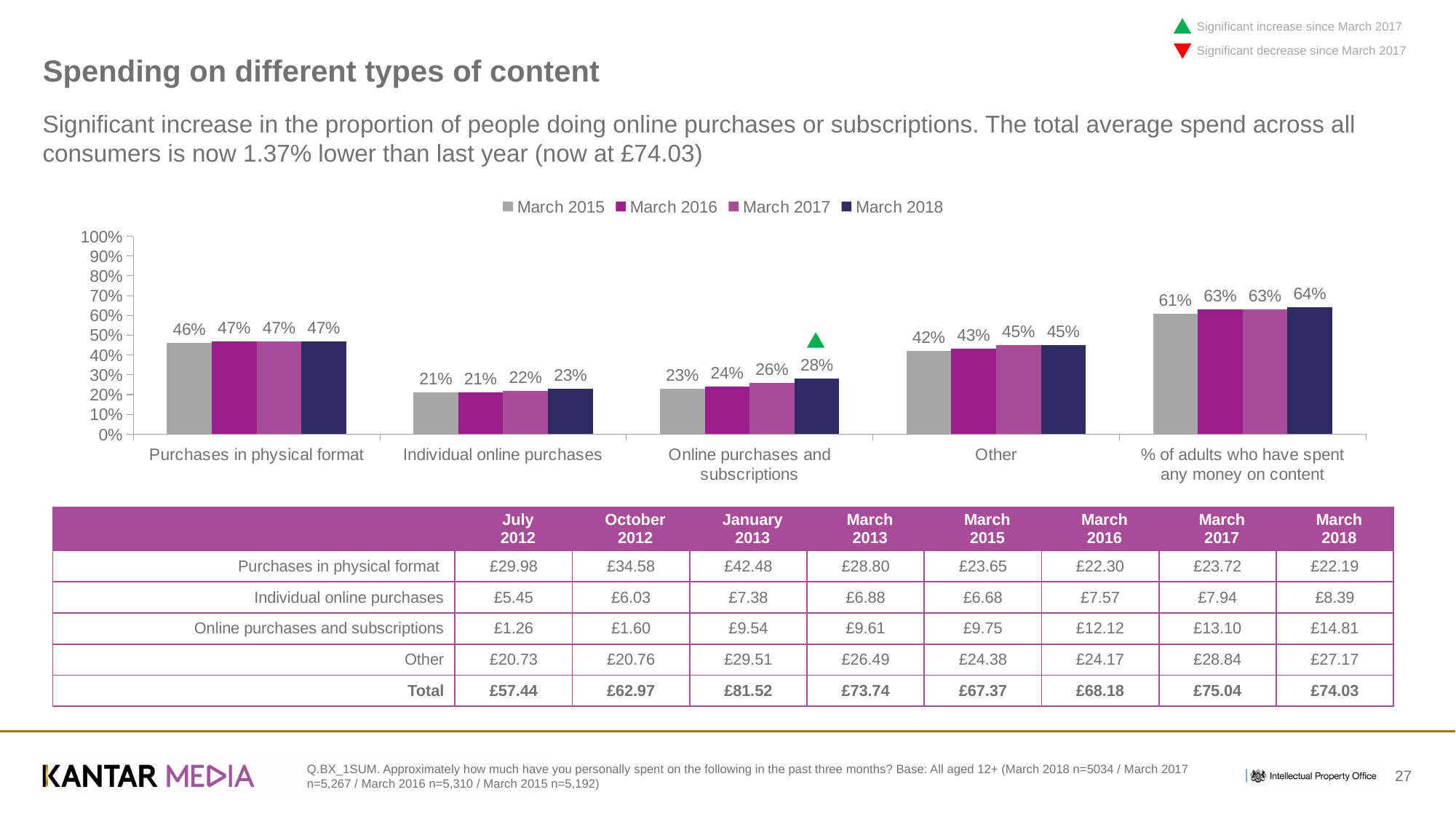
What is the March 2018 value for Online purchases and subscriptions? 28% Which is larger: the March 2018 value for Other or the March 2018 value for Individual online purchases? Other What is the March 2017 value for Other? 45% What kind of chart is shown on the slide? Bar chart Which series in the legend is shown in grey? March 2015 What is the difference between the March 2018 and March 2015 values for Online purchases and subscriptions? 5% What is the March 2015 value for Purchases in physical format? 46% How many series does the chart legend list? 4 Do the values for Online purchases and subscriptions rise or fall from March 2015 to March 2018? Rise How many categories are shown on the x axis of the chart? 5 Which category has the highest March 2018 value? % of adults who have spent any money on content Which category has the lowest March 2015 value? Individual online purchases